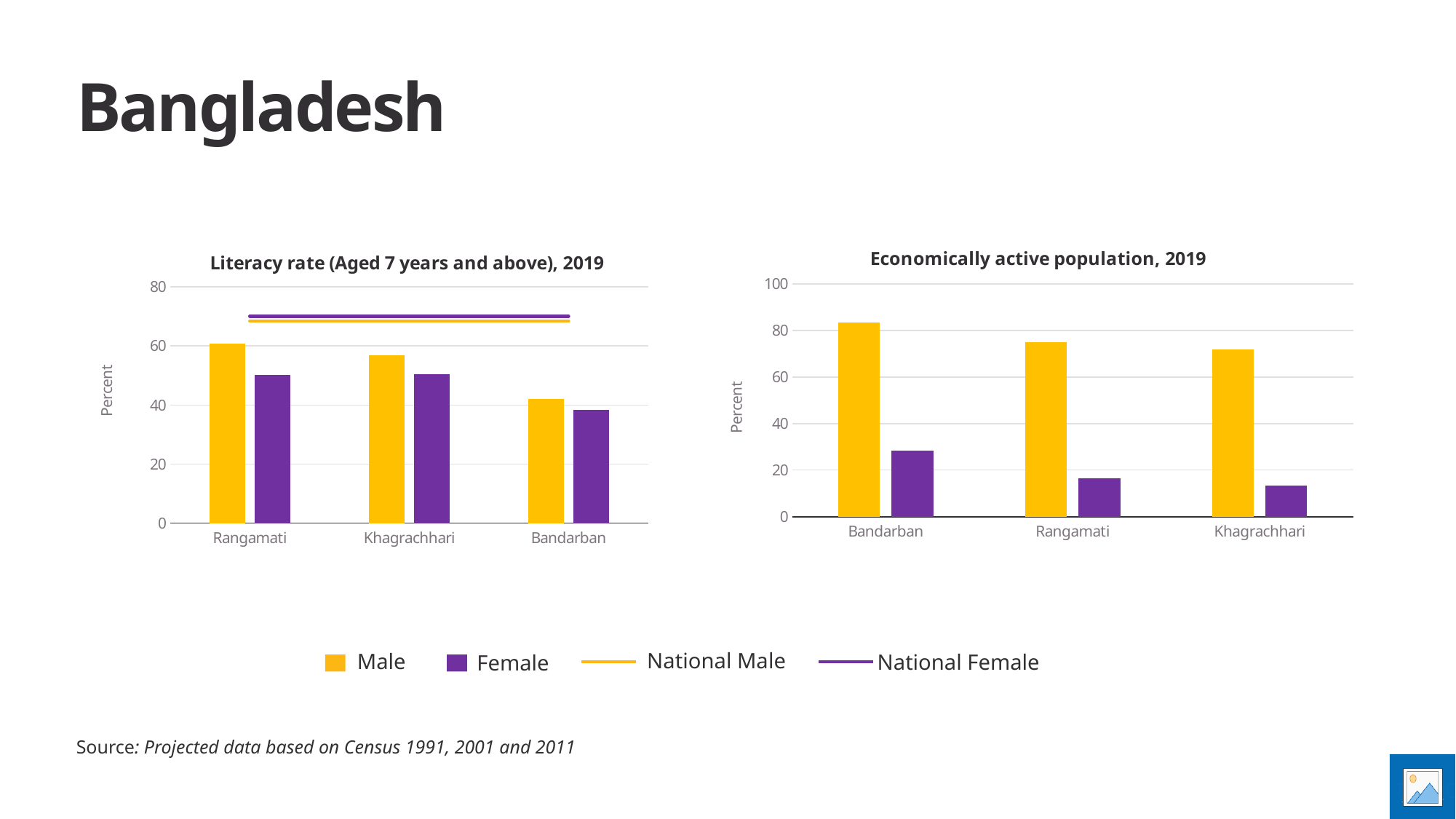
In the 'Economically active population, 2019' chart, which district has the highest Male value? Bandarban In the 'Economically active population, 2019' chart, is the Male value for Bandarban greater or less than 80? greater In the 'Economically active population, 2019' chart, which district has the lowest Female value? Khagrachhari In the 'Economically active population, 2019' chart, is the Female value for Rangamati greater or less than 20? less In the 'Economically active population, 2019' chart, which is larger for Bandarban, the Male value or the Female value? Male How many districts are shown on the x axis of the 'Economically active population, 2019' chart? 3 In the 'Literacy rate (Aged 7 years and above), 2019' chart, which district has the highest Male literacy rate? Rangamati In the 'Literacy rate (Aged 7 years and above), 2019' chart, which district has the lowest Female literacy rate? Bandarban What kind of chart is the 'Economically active population, 2019' chart? Bar chart In the 'Literacy rate (Aged 7 years and above), 2019' chart, is the Male value for Khagrachhari greater or less than 60? less